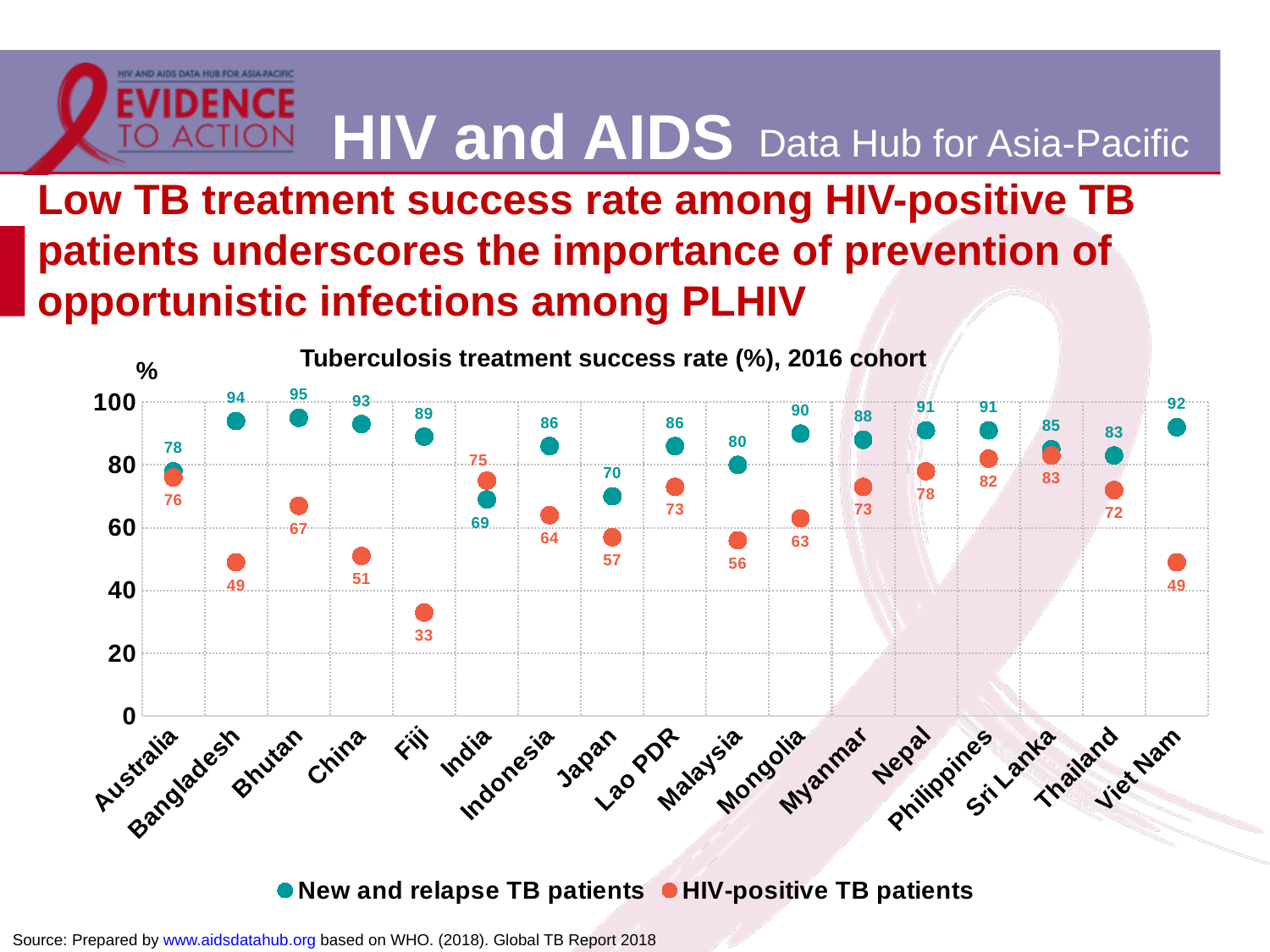
What is the difference between the success rates for new and relapse TB patients and HIV-positive TB patients in Bangladesh? 45 How many series does the chart legend list? 2 Which country has the lowest TB treatment success rate among new and relapse TB patients? India What is the title of the chart? Tuberculosis treatment success rate (%), 2016 cohort Which country has the highest TB treatment success rate among new and relapse TB patients? Bhutan How many countries are shown on the x axis of the chart? 17 In India, which group has the higher TB treatment success rate: new and relapse TB patients or HIV-positive TB patients? HIV-positive TB patients Which country has the lowest TB treatment success rate among HIV-positive TB patients? Fiji What is the TB treatment success rate for new and relapse TB patients in Bhutan? 95 What type of chart is used to show the TB treatment success rates? Scatter (dot) chart What is the TB treatment success rate for HIV-positive TB patients in Fiji? 33 What is the TB treatment success rate for HIV-positive TB patients in Viet Nam? 49